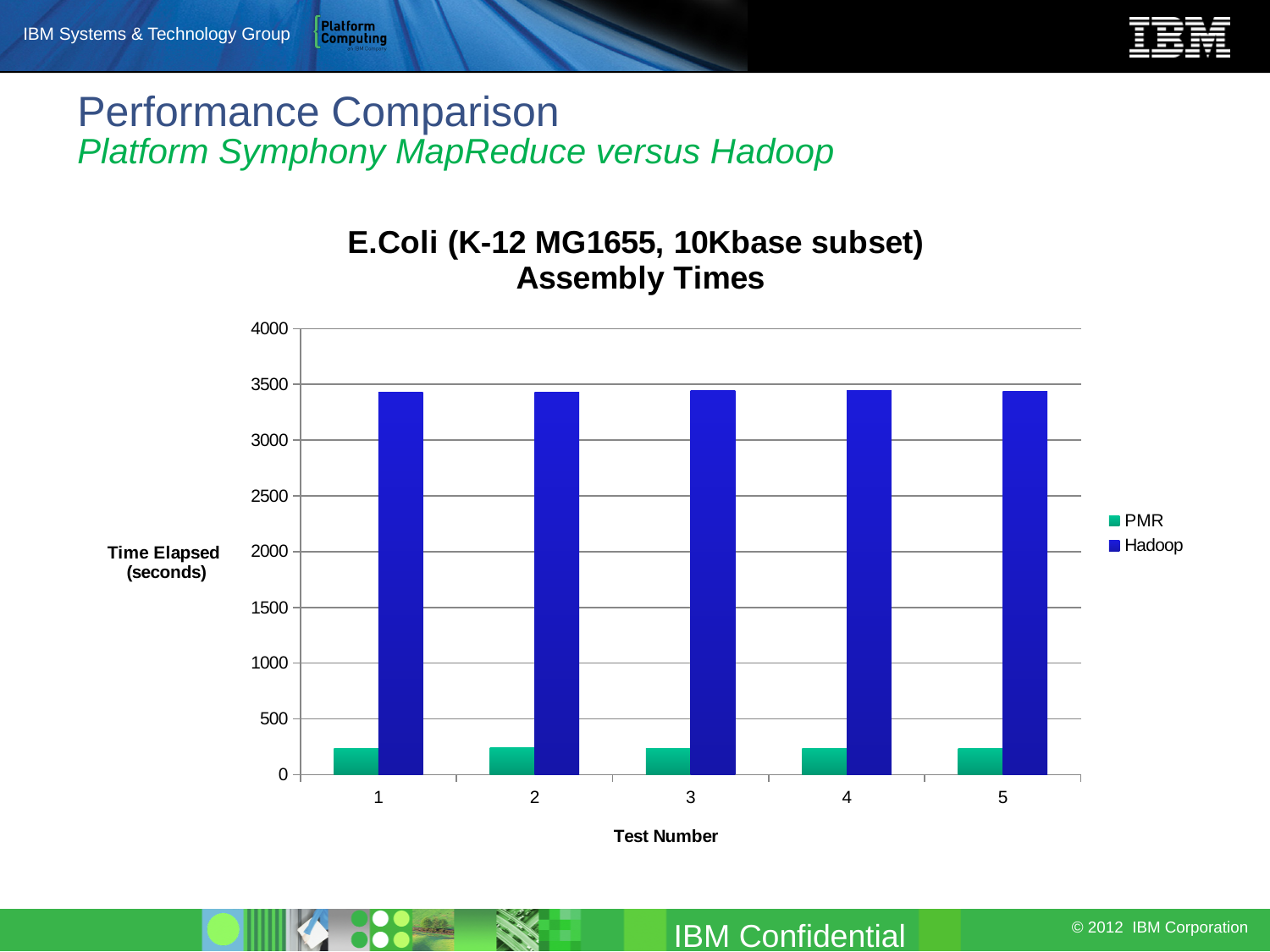
Which series has the larger value for test number 3, PMR or Hadoop? Hadoop Is the Hadoop value for test number 5 greater or less than 3500? less What kind of chart is shown on the slide? bar chart Is the Hadoop value for test number 1 greater or less than 3000? greater Which series has the smaller value for test number 5, PMR or Hadoop? PMR What is the title of the chart? E.Coli (K-12 MG1655, 10Kbase subset) Assembly Times How many series does the legend list? 2 How many test numbers are shown along the x axis? 5 Is the PMR value for test number 2 greater or less than 500? less What is the label of the y axis? Time Elapsed (seconds)